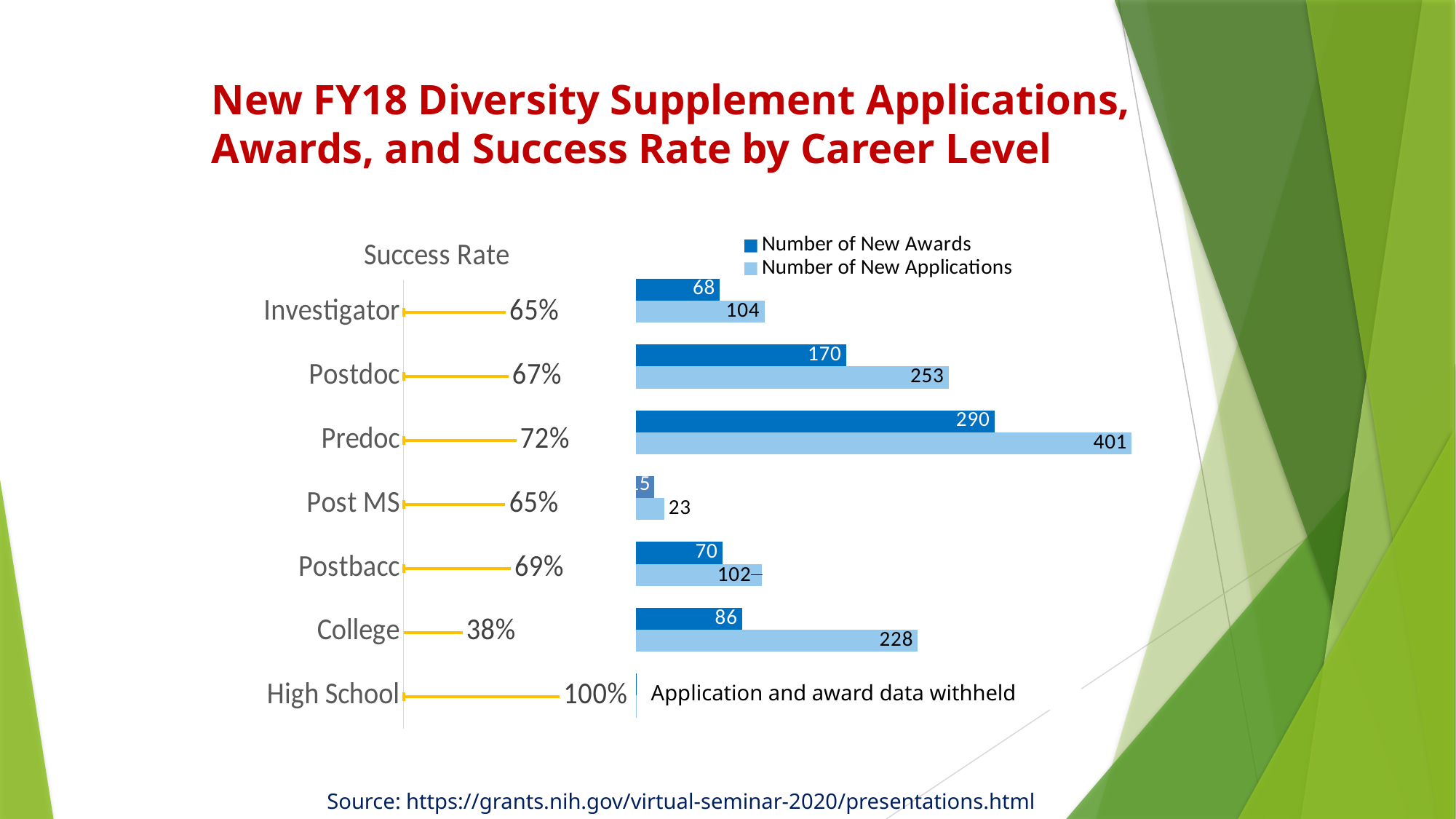
In the bar chart, which career level has the lowest Number of New Applications? Post MS In the Success Rate chart, which career level has the lowest success rate? College In the bar chart, what is the Number of New Applications for Predoc? 401 In the Success Rate chart, what is the success rate for High School? 100% In the bar chart, which career level has the highest Number of New Applications? Predoc How many series does the legend of the bar chart list? 2 In the bar chart, what text is shown in place of the High School bars? Application and award data withheld In the bar chart, which is larger: the Number of New Awards for Investigator or for Postbacc? Postbacc In the bar chart, what is the difference between the Number of New Applications and the Number of New Awards for College? 142 What kind of chart is the chart on the right showing Number of New Awards and Number of New Applications? Bar chart In the bar chart, what is the Number of New Awards for Postdoc? 170 In the Success Rate chart, what is the success rate for College? 38%